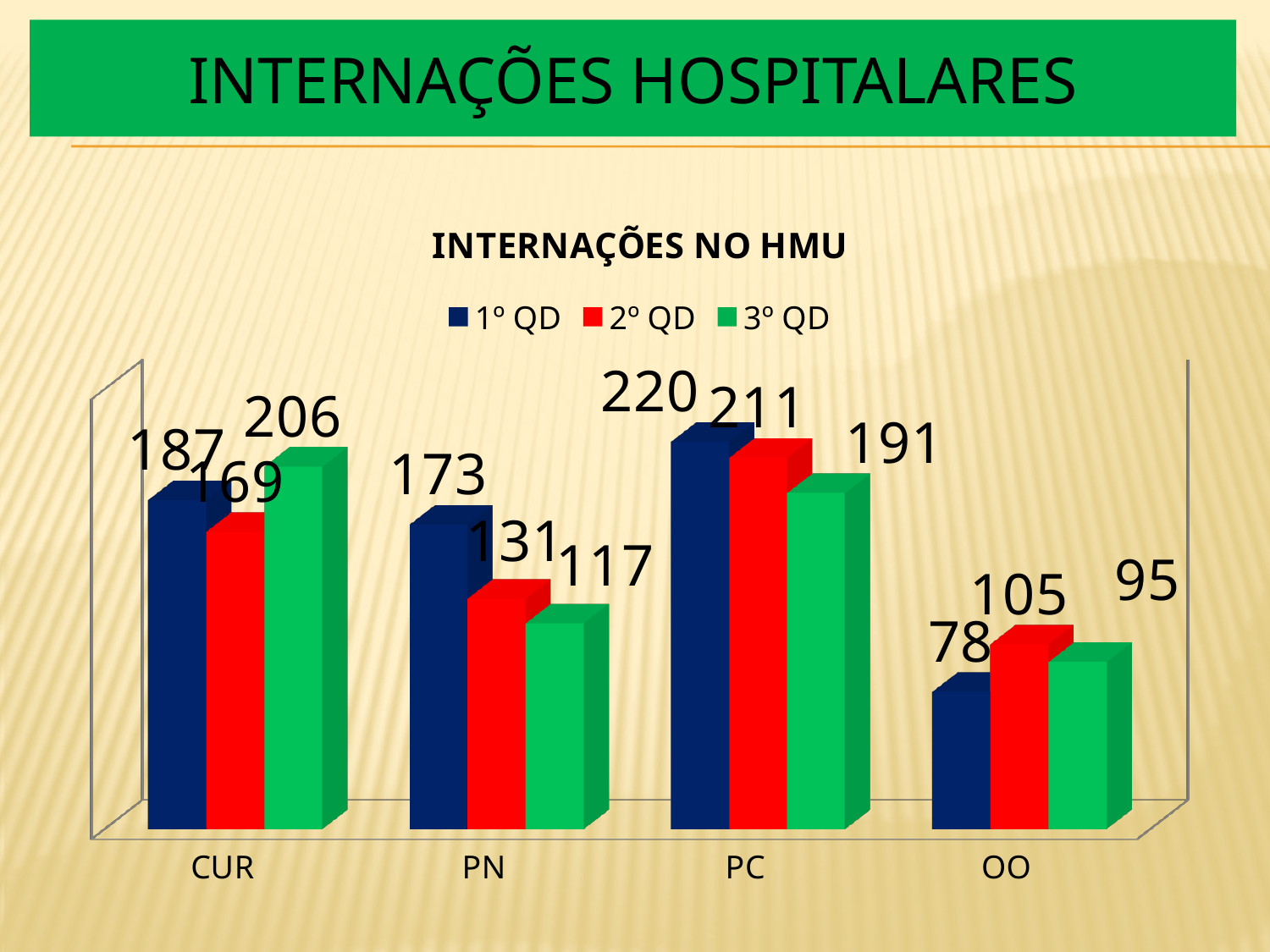
What is the title of the chart? INTERNAÇÕES NO HMU What is the value for 1º QD in the CUR category? 187 What kind of chart is shown? bar chart How many series does the legend list? 3 Which category has the highest 1º QD value? PC Which colour represents the 2º QD series? red What is the value for 3º QD in the PN category? 117 What is the difference between the 1º QD and 3º QD values for PC? 29 Which category has the lowest 3º QD value? OO How many categories are shown on the x axis? 4 Which is larger for CUR: the 2º QD value or the 3º QD value? 3º QD What is the value for 2º QD in the OO category? 105